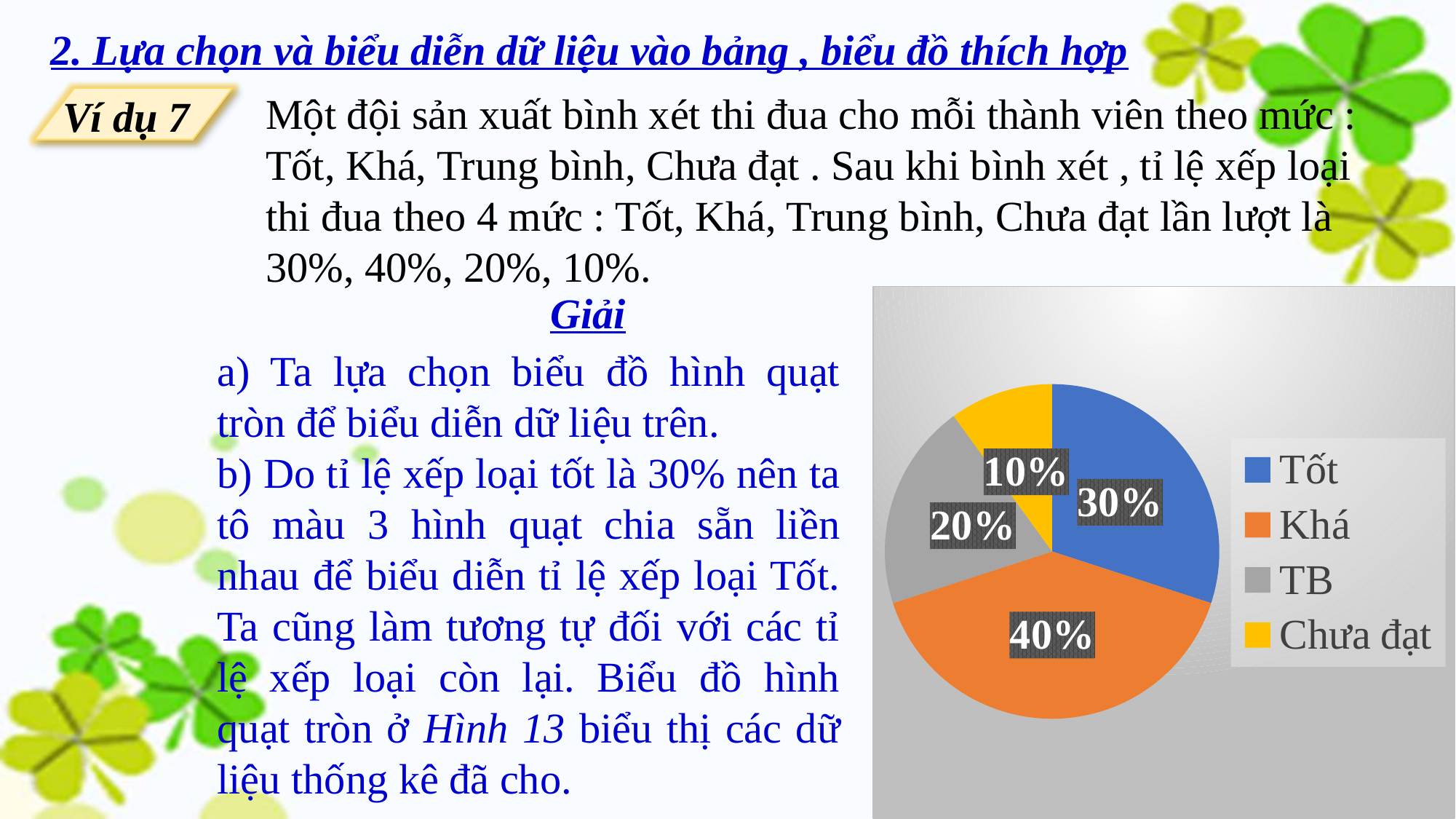
How many slices does the pie chart have? 4 What percentage does the TB slice show? 20% What is the difference between the Khá and Tốt percentages? 10% Which is larger, the TB slice or the Chưa đạt slice? TB Which category has the smallest slice of the pie? Chưa đạt What percentage does the Khá slice show? 40% What kind of chart is shown on the slide? pie chart What percentage does the Tốt slice show? 30% Which category has the largest slice of the pie? Khá How many entries does the legend list? 4 What percentage does the Chưa đạt slice show? 10% What colour is the Khá slice in the pie chart? orange